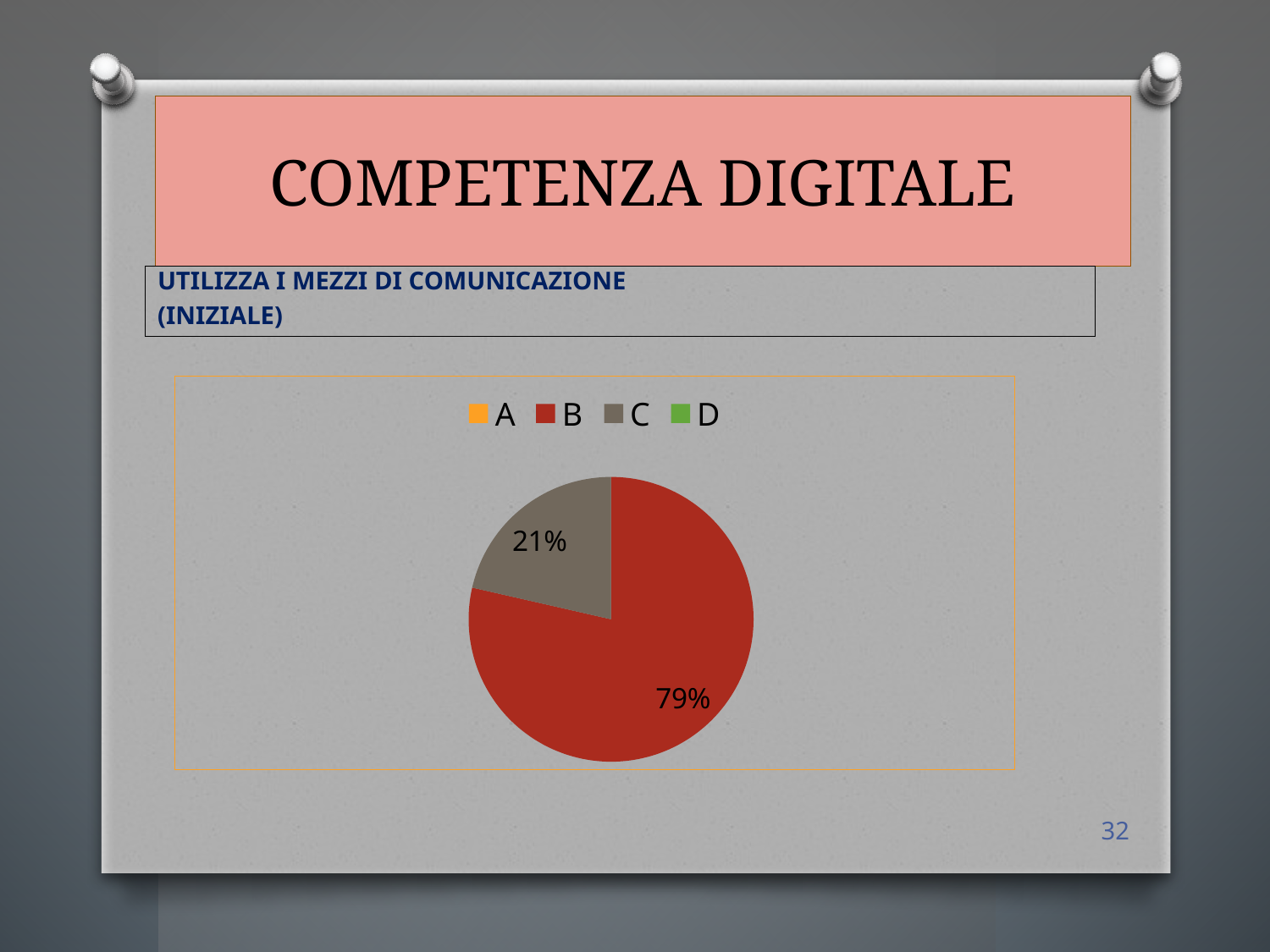
What type of chart is shown on the slide? Pie chart What is the difference in percentage points between slice B and slice C? 58 percentage points Which category has the largest slice in the pie chart? B How many slices are visibly drawn in the pie chart? 2 Of the two labelled slices, B and C, which is smaller? C What are the entries listed in the chart legend? A, B, C, D What share of the pie does category B take? 79% What percentage does slice C represent in the pie chart? 21% Which is larger in the pie chart, slice B or slice C? B How many categories does the legend of the chart list? 4 What colour is the slice for category B? Red What percentage does slice B represent in the pie chart? 79%